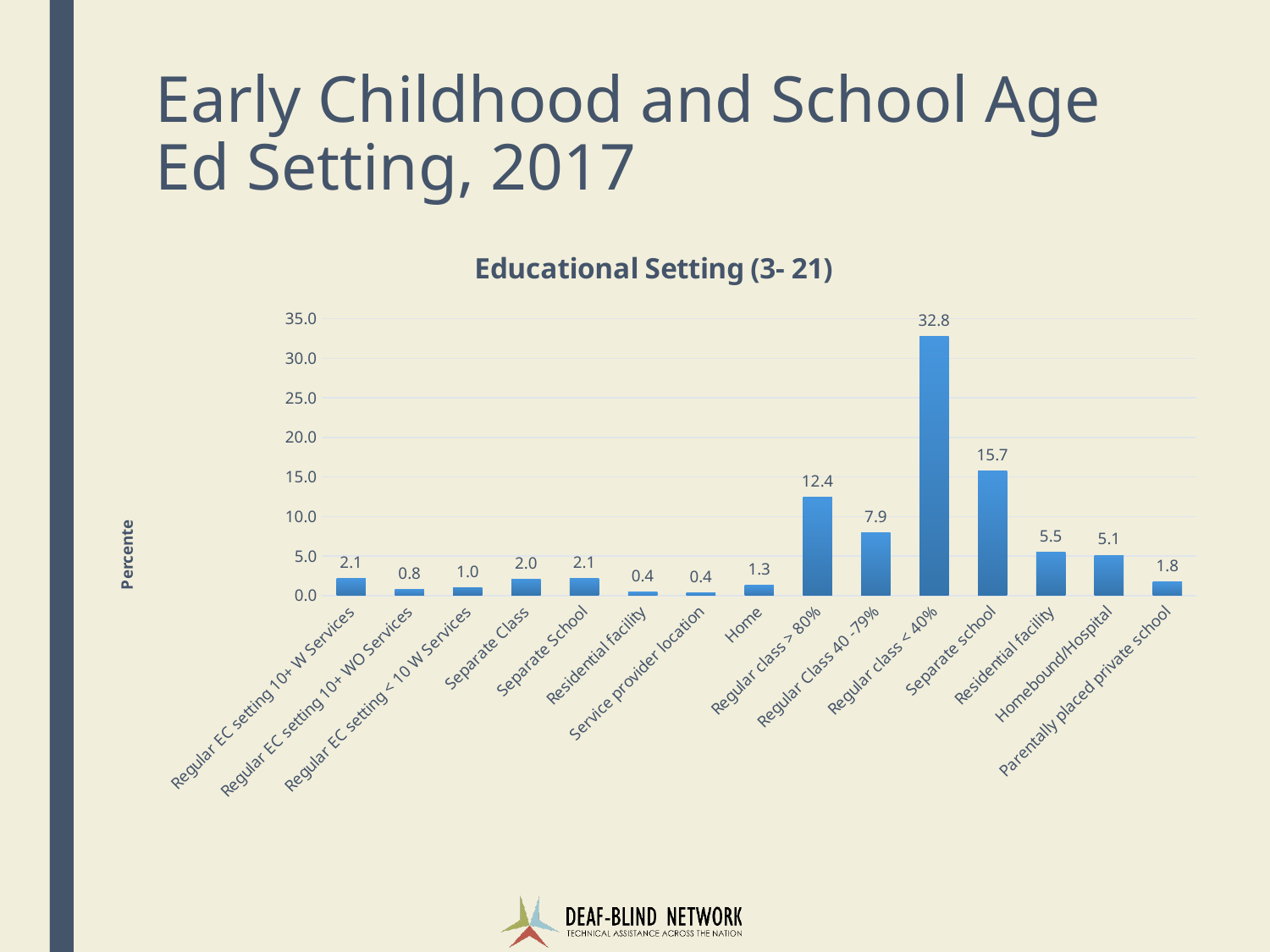
What is the value for Regular EC setting 10+ WO Services? 0.8 Which category has the highest value? Regular class < 40% Is the value for Regular class < 40% greater or less than 30.0? greater What kind of chart is shown on the slide? bar chart What is the difference between the values for Regular class < 40% and Regular class > 80%? 20.4 What is the value for Homebound/Hospital? 5.1 What is the title of the chart? Educational Setting (3- 21) Which is larger, the value for Regular class > 80% or the value for Regular Class 40 -79%? Regular class > 80% What is the value for Regular class > 80%? 12.4 How many categories are shown on the x axis? 15 What is the difference between the values for Regular Class 40 -79% and Homebound/Hospital? 2.8 What is the value for Home? 1.3